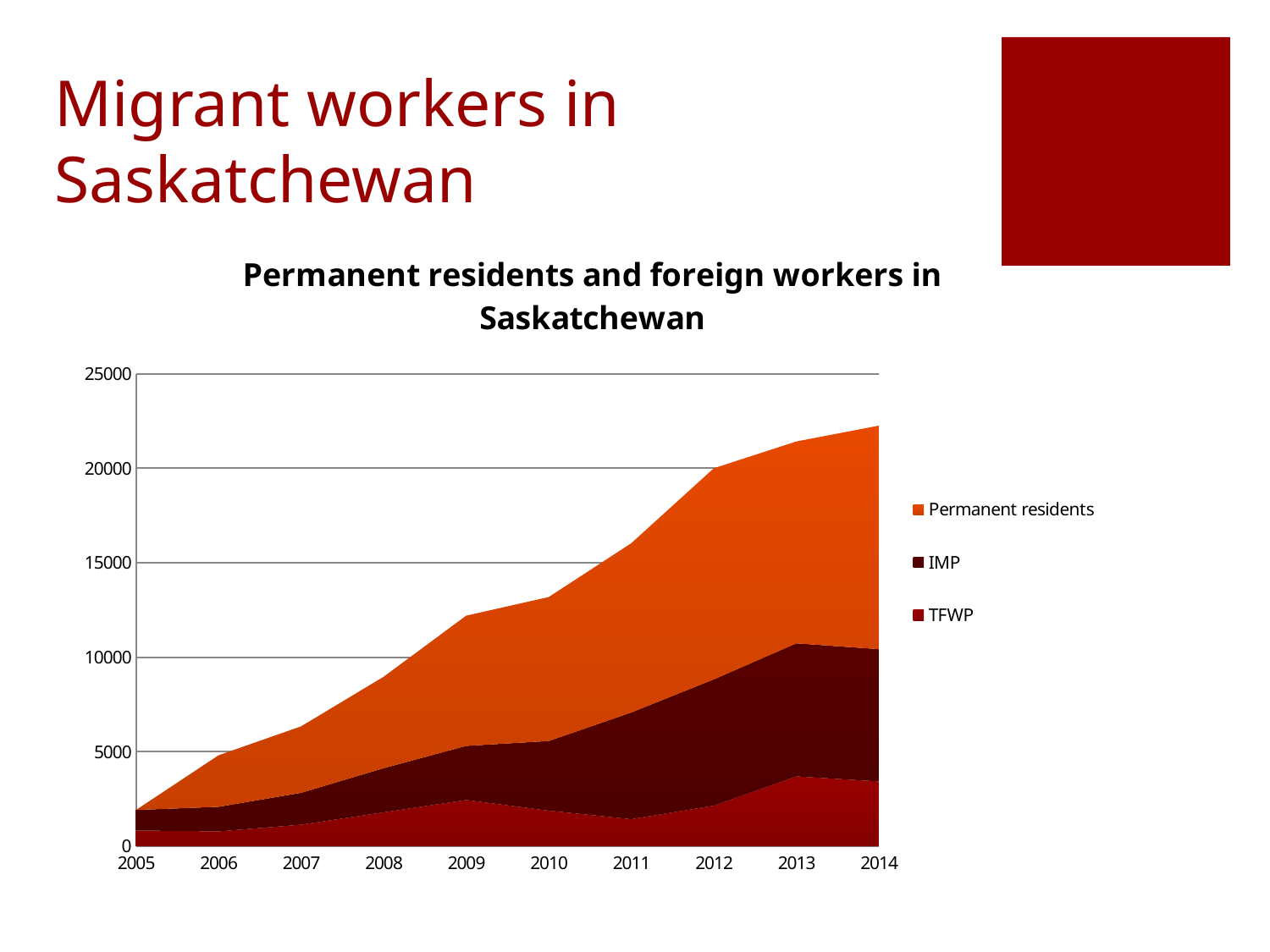
Which year has the highest stacked total? 2014 What kind of chart is shown on the slide? Stacked area chart Does the stacked total rise or fall from 2005 to 2014? Rises Is the stacked total for 2011 greater or less than 15000? greater Which series are listed in the legend? Permanent residents, IMP, TFWP How many years are plotted along the x axis? 10 Is the stacked total for 2005 greater or less than 5000? less Is the stacked total for 2009 greater or less than 10000? greater How many series does the legend list? 3 What is the title of the chart? Permanent residents and foreign workers in Saskatchewan Which year has the lowest stacked total? 2005